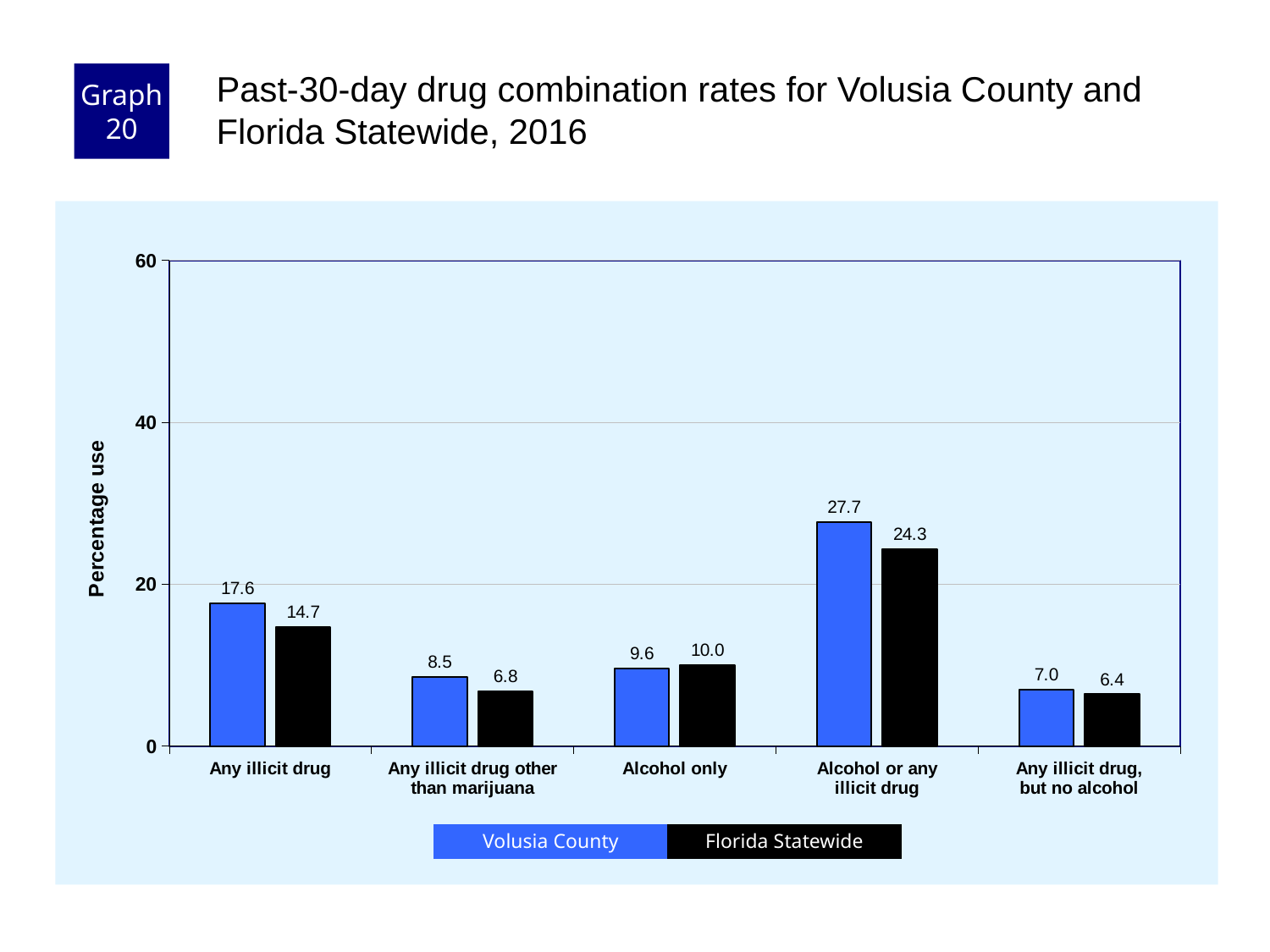
Which category has the lowest Florida Statewide value? Any illicit drug, but no alcohol What is the difference between the Volusia County and Florida Statewide values for Alcohol or any illicit drug? 3.4 Which is larger for Alcohol only: the Volusia County value or the Florida Statewide value? Florida Statewide What is the Volusia County value for Any illicit drug? 17.6 What is the Florida Statewide value for Any illicit drug, but no alcohol? 6.4 How many series does the legend list? 2 What is the Florida Statewide value for Alcohol only? 10.0 Is the Volusia County value for Alcohol or any illicit drug greater or less than 20? greater What is the label of the y axis? Percentage use What kind of chart is shown on the slide? Bar chart Which category has the highest Volusia County value? Alcohol or any illicit drug How many categories are shown on the x axis? 5